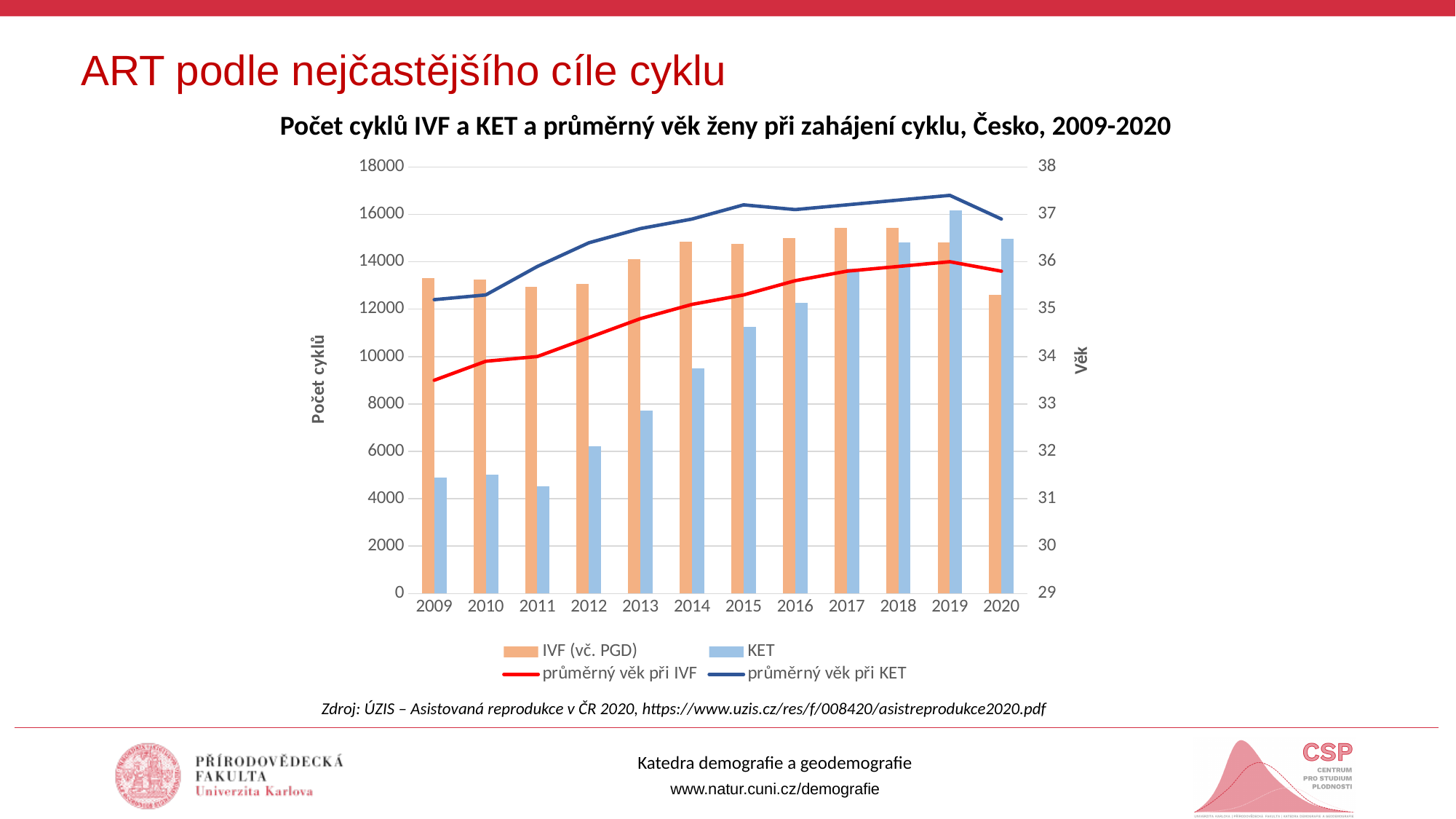
Is the KET value for 2009 greater or less than 6000? less How many years (categories) are shown on the x axis? 12 In which year is the KET bar lowest? 2011 What kind of chart is shown on the slide? A combined bar and line chart Is the average age at KET (průměrný věk při KET) in 2019 greater or less than 37? greater Does the number of KET cycles generally rise or fall from 2009 to 2019? rise In which year is the KET bar highest? 2019 Is the IVF (vč. PGD) value for 2020 greater or less than 12000? greater In 2020, which is larger: the IVF (vč. PGD) bar or the KET bar? KET How many series does the legend list? 4 In 2009, which is larger: the IVF (vč. PGD) bar or the KET bar? IVF (vč. PGD)